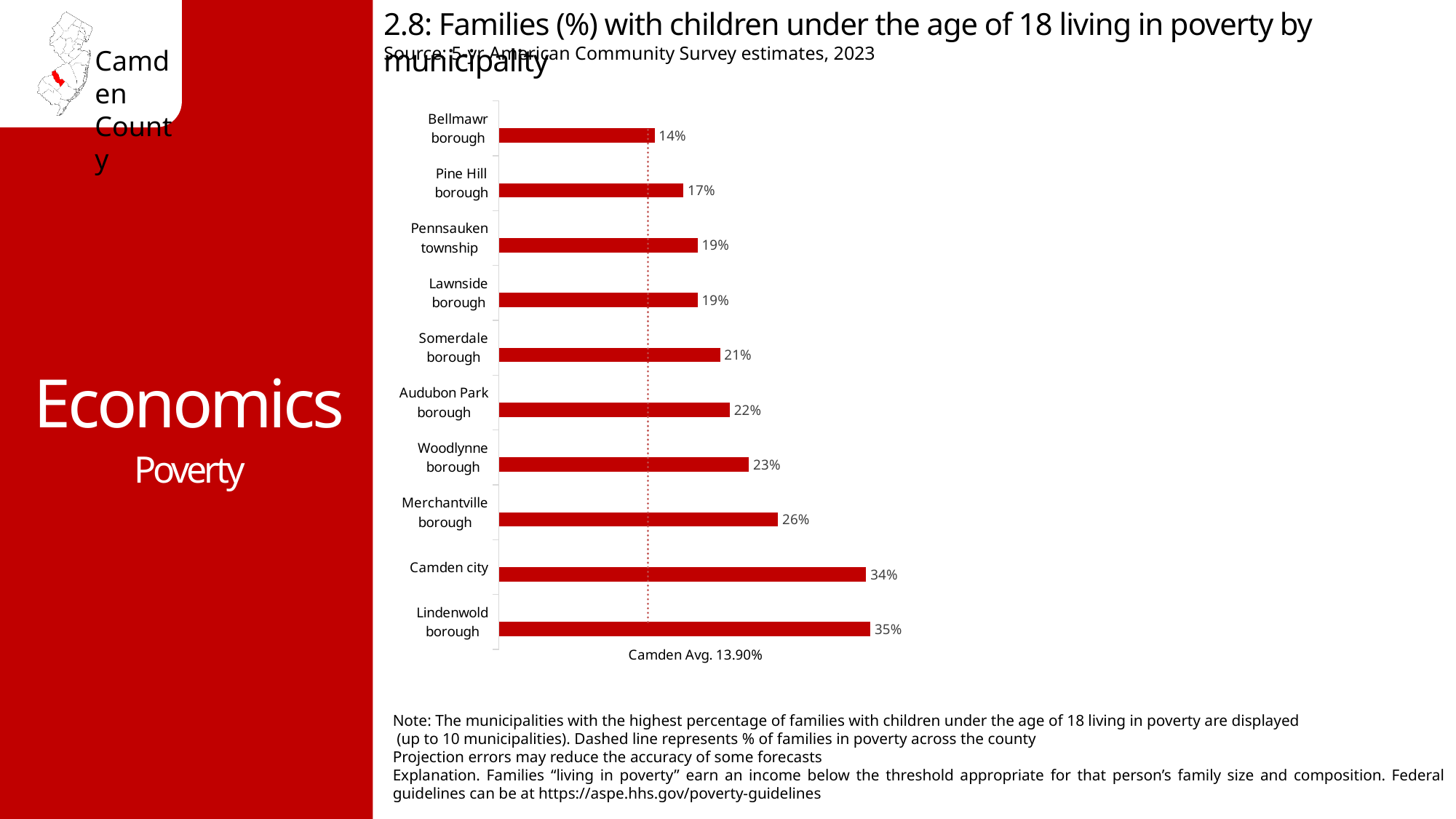
What kind of chart is shown on the slide? Bar chart What is the value for Camden city? 34% Which two municipalities both have a value of 19%? Pennsauken township and Lawnside borough What is the difference between the values for Merchantville borough and Somerdale borough? 5% Which municipality has the lowest value? Bellmawr borough How many municipalities are shown in the chart? 10 What is the value for Bellmawr borough? 14% What is the difference between the values for Lindenwold borough and Bellmawr borough? 21% Which municipality has the highest value? Lindenwold borough Which is larger, the value for Pine Hill borough or the value for Audubon Park borough? Audubon Park borough What is the value for Woodlynne borough? 23% What is the Camden average shown by the dashed line? 13.90%